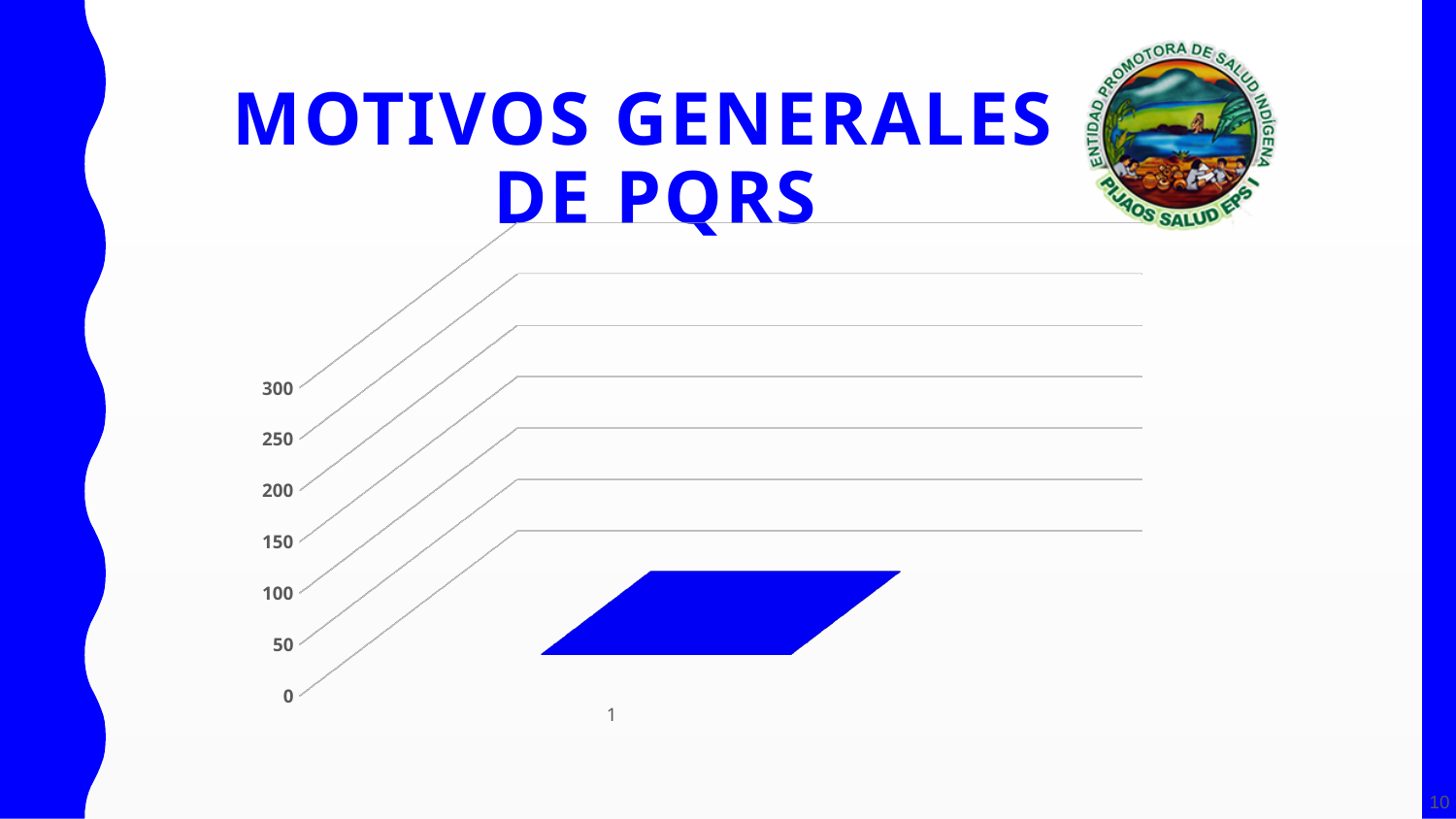
What kind of chart is shown on the slide? bar chart Is the value for category 1 greater or less than 100? less What is the highest value labelled on the vertical axis of the chart? 300 Is the value for category 1 greater or less than 50? less What is the title shown above the chart? MOTIVOS GENERALES DE PQRS How many categories are plotted on the x axis of the chart? 1